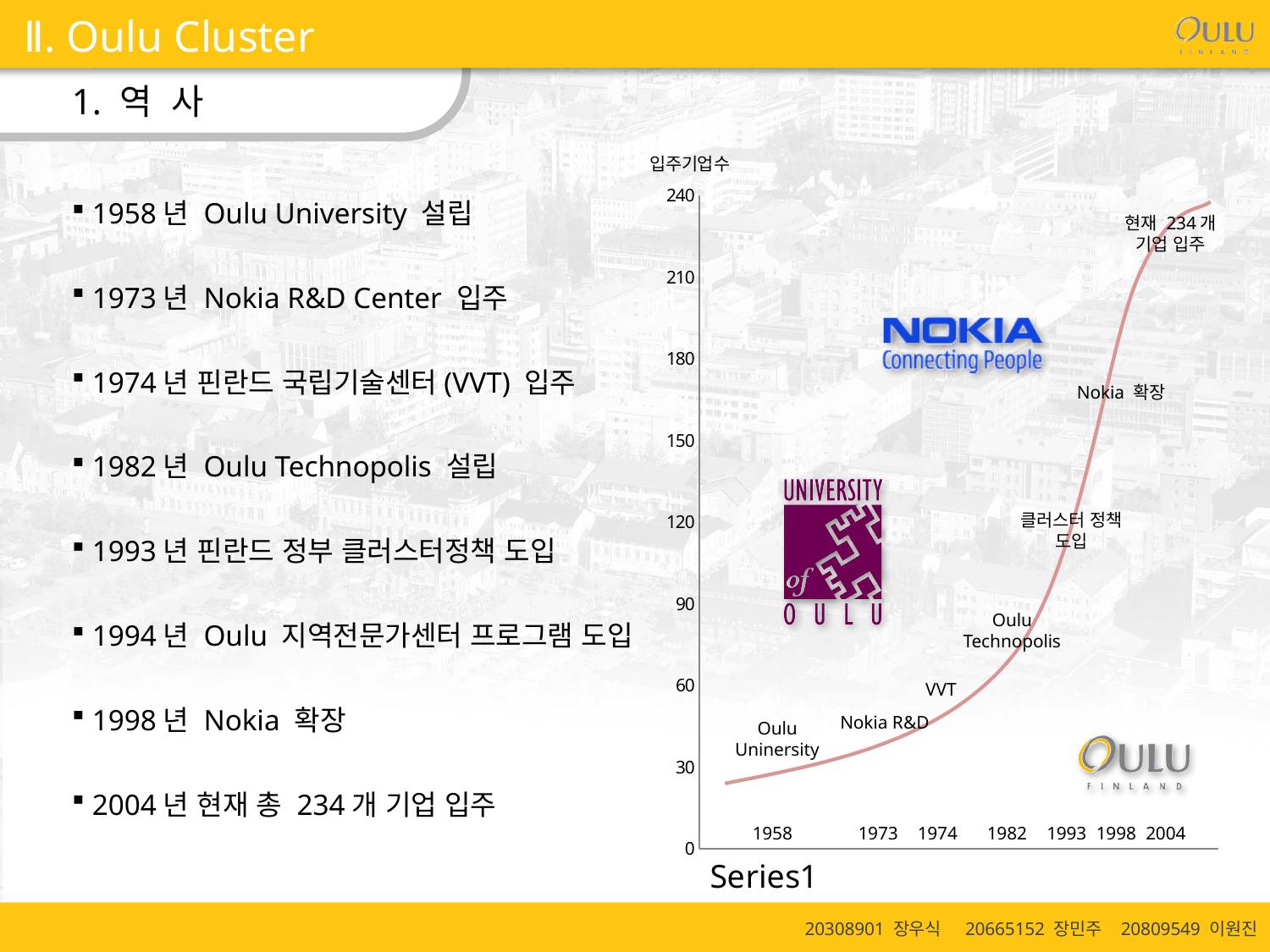
Which year on the x axis has the highest value in the chart? 2004 What kind of chart is shown on the slide? line chart According to the annotation on the chart, how many companies are tenants in 2004? 234개 How many series does the chart's legend list? 1 Do the values in the chart rise or fall from 1958 to 2004? rise What is the label on the vertical axis of the chart? 입주기업수 Which year on the x axis has the lowest value in the chart? 1958 How many years are labelled along the x axis of the chart? 7 What is the name of the series shown in the chart legend? Series1 Is the value for 1982 greater or less than 60? greater Is the value for 1998 greater or less than 150? greater